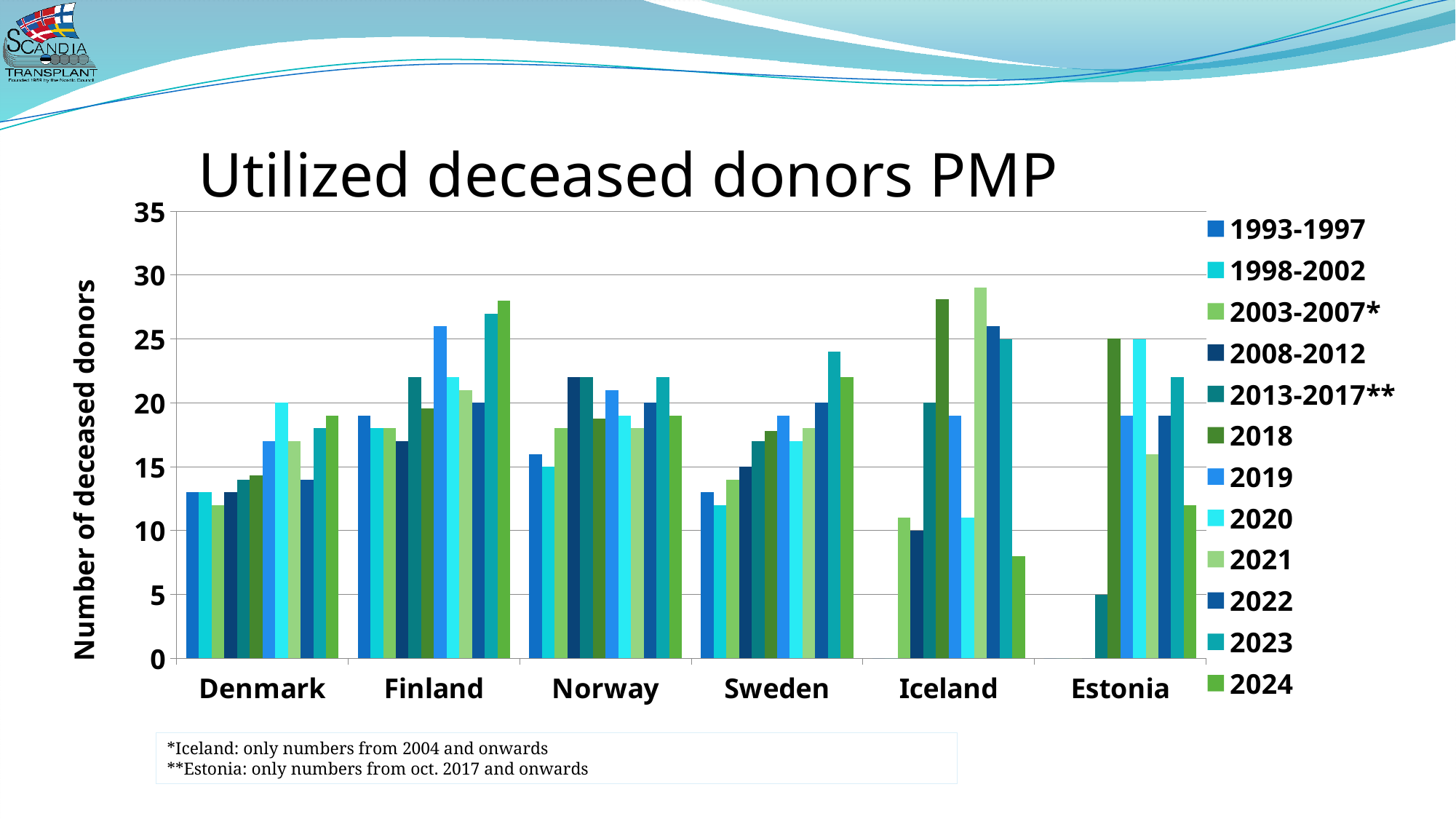
How many series does the legend list? 12 How many countries are shown on the x axis? 6 Is the value for Iceland in 2024 greater or less than 10? less Which is larger, the 2024 value for Finland or the 2024 value for Denmark? Finland Which period has the lowest value for Estonia? 2013-2017** What is the label on the vertical axis? Number of deceased donors Which period has the lowest value for Iceland? 2024 Is the value for Sweden in 2023 greater or less than 20? greater Is the value for Finland in 2024 greater or less than 25? greater What kind of chart is shown on the slide? Bar chart What is the title of the chart? Utilized deceased donors PMP